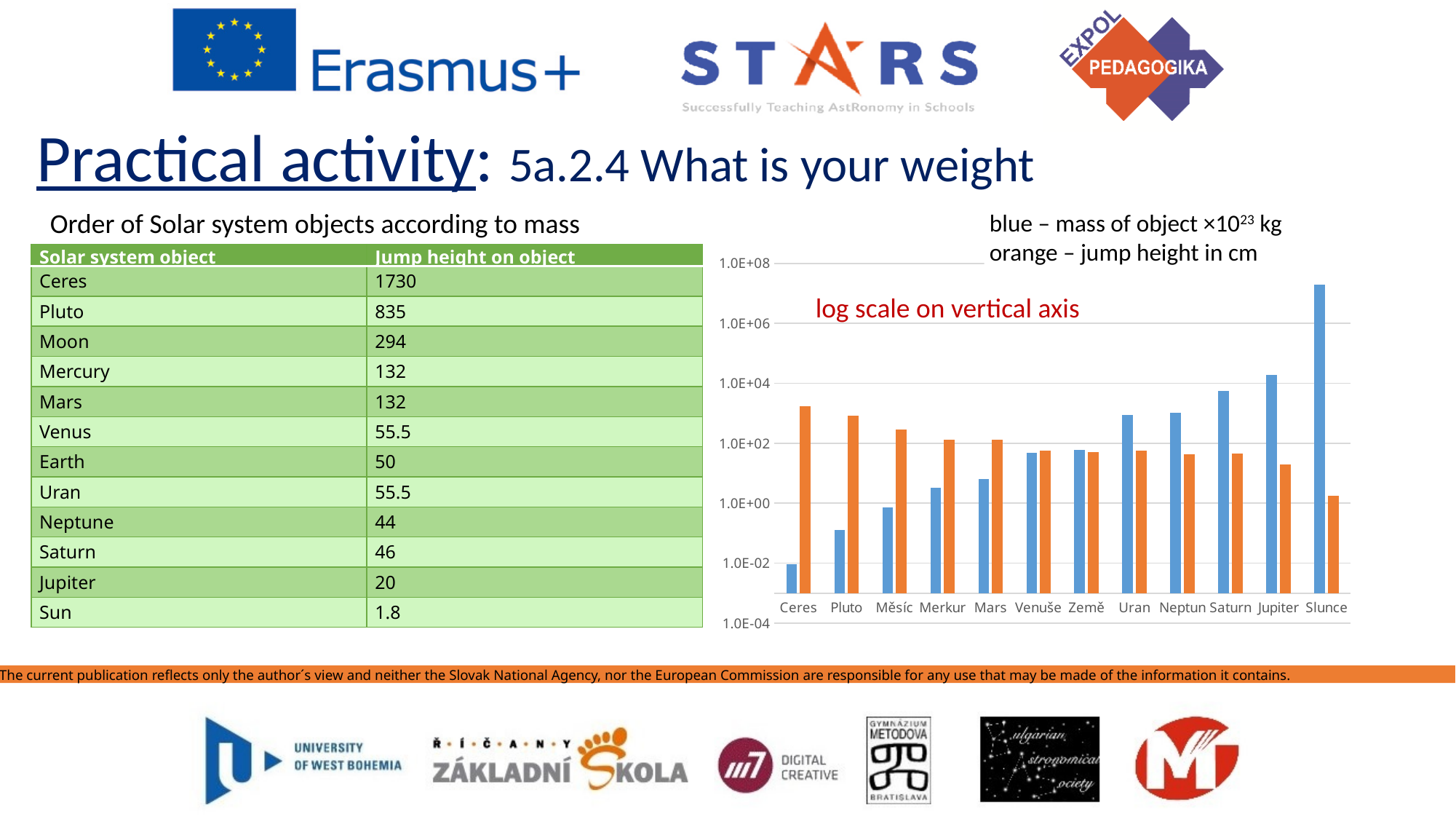
Is the orange bar value for Ceres greater or less than 1.0E+02? greater How many Solar system objects are shown on the x axis of the chart? 12 Which object has the shortest blue bar in the chart? Ceres Is the blue bar value for Slunce greater or less than 1.0E+06? greater For Ceres, which bar is taller, the blue one or the orange one? orange According to the red text on the chart, what kind of scale is used on the vertical axis? log scale Is the blue bar value for Pluto greater or less than 1.0E+00? less Which object has the shortest orange bar in the chart? Slunce Do the blue bars generally rise or fall from Ceres to Slunce along the x axis? rise Which object has the tallest blue bar in the chart? Slunce Which object has the tallest orange bar in the chart? Ceres What kind of chart is shown on the slide? bar chart